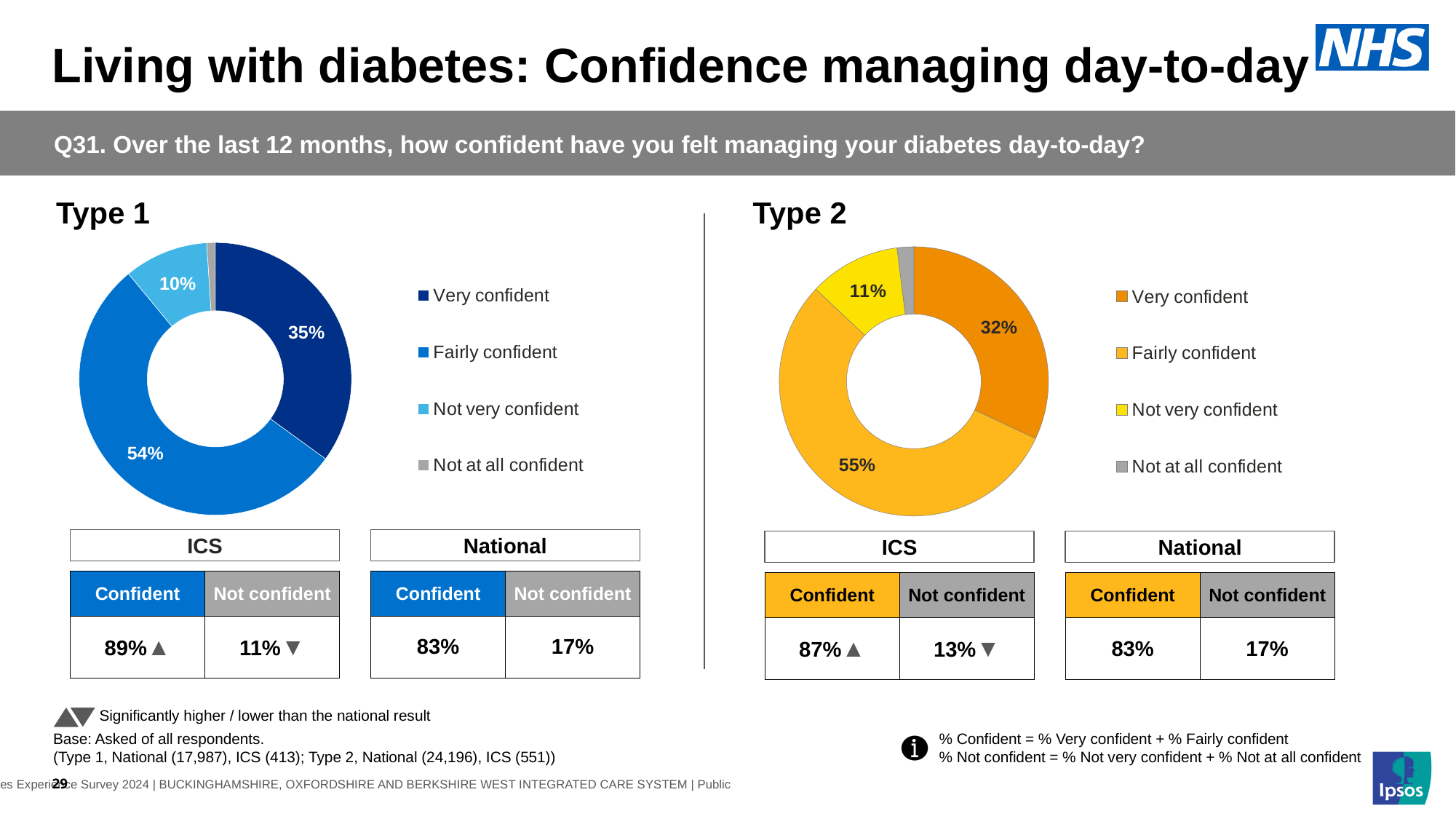
What kind of chart is used for Type 2? Donut (pie) chart In the Type 2 chart, what colour represents the 'Not very confident' category? Yellow In the Type 1 chart, what percentage of respondents were fairly confident? 54% In the Type 1 chart, what percentage of respondents were very confident? 35% In the Type 1 chart, which category has the largest share? Fairly confident In the Type 2 chart, what percentage of respondents were not very confident? 11% In the Type 2 chart, what percentage of respondents were fairly confident? 55% In the Type 2 chart, which category has the smallest share? Not at all confident In the Type 2 chart, what is the difference in percentage points between fairly confident and very confident? 23 In the Type 1 chart, what is the difference in percentage points between very confident and not very confident? 25 Which is larger: the very confident share in the Type 1 chart or the very confident share in the Type 2 chart? Type 1 How many categories does the legend of the Type 1 chart list? 4